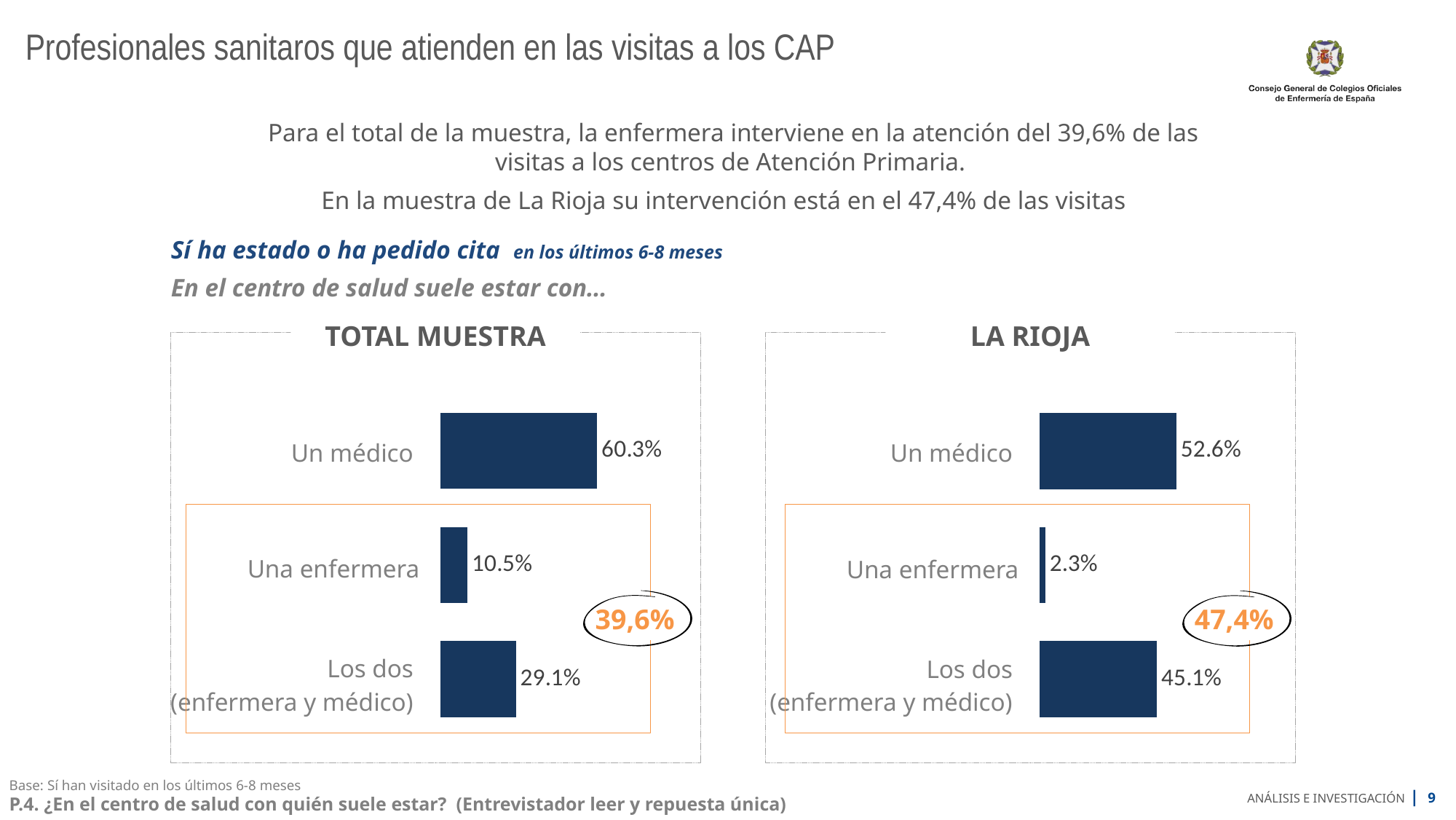
In the TOTAL MUESTRA chart, what is the value for Una enfermera? 10.5% What kind of chart is the LA RIOJA chart? Bar chart In the LA RIOJA chart, which category has the highest value? Un médico In the LA RIOJA chart, what is the difference between Un médico and Una enfermera? 50.3% How many categories does the TOTAL MUESTRA chart show? 3 In the LA RIOJA chart, what is the value for Los dos (enfermera y médico)? 45.1% In the TOTAL MUESTRA chart, what is the difference between Un médico and Los dos (enfermera y médico)? 31.2% In the LA RIOJA chart, what is the value for Una enfermera? 2.3% In the TOTAL MUESTRA chart, what is the value for Un médico? 60.3% Which is larger: Los dos (enfermera y médico) in the TOTAL MUESTRA chart or Los dos (enfermera y médico) in the LA RIOJA chart? LA RIOJA What value is circled in orange next to the LA RIOJA chart? 47,4% In the TOTAL MUESTRA chart, which category has the lowest value? Una enfermera